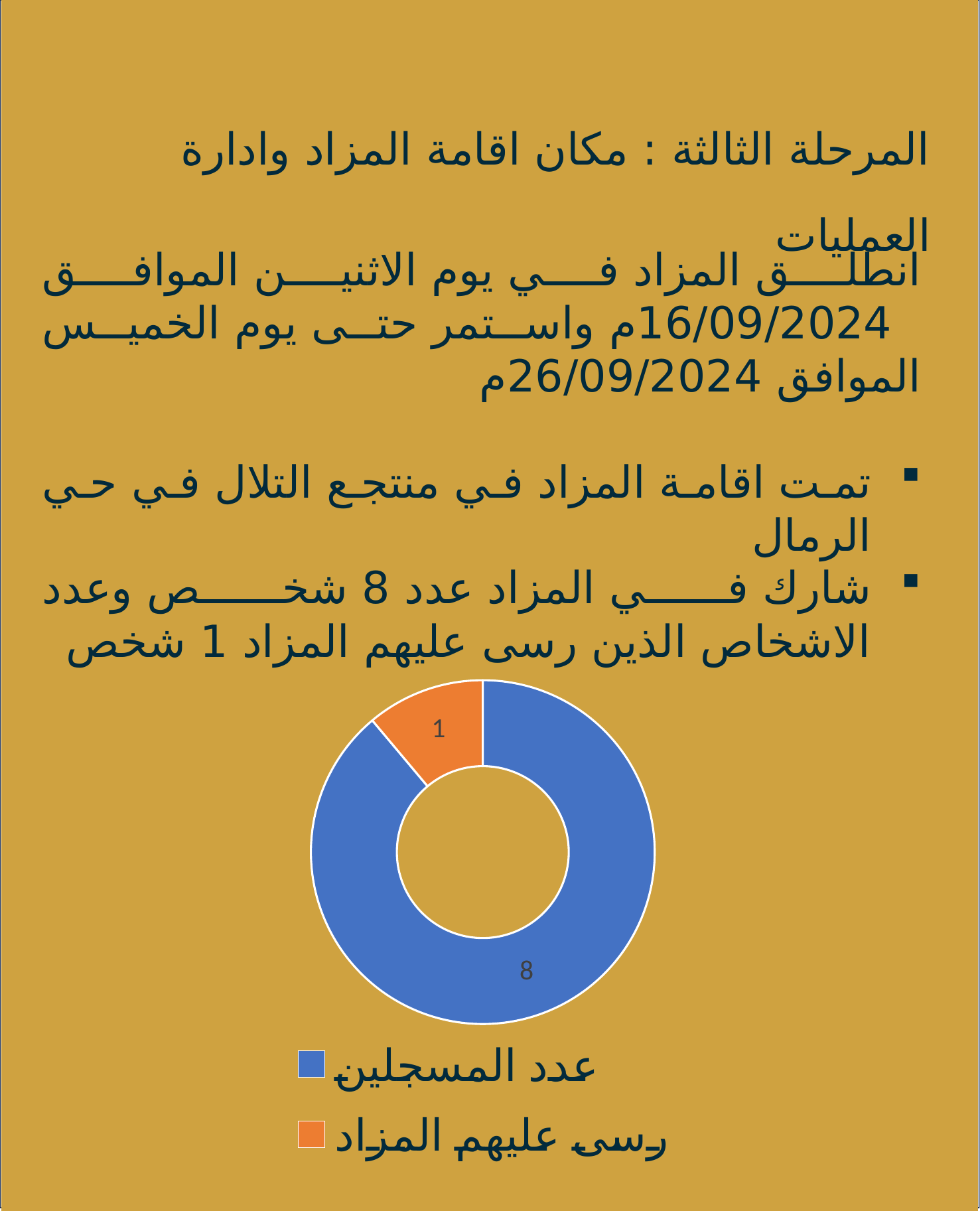
What colour is the slice for رسى عليهم المزاد? Orange Which category has the smallest slice in the chart? رسى عليهم المزاد What type of chart is shown on the slide? Doughnut (pie) chart How many slices does the chart have? 2 What is the value for رسى عليهم المزاد in the chart? 1 What colour is the slice for عدد المسجلين? Blue Which is larger, the value for عدد المسجلين or the value for رسى عليهم المزاد? عدد المسجلين What is the value for عدد المسجلين in the chart? 8 Which category has the largest slice in the chart? عدد المسجلين How many entries does the chart legend list? 2 What is the difference between the values for عدد المسجلين and رسى عليهم المزاد? 7 What is the total of the two values shown in the chart? 9